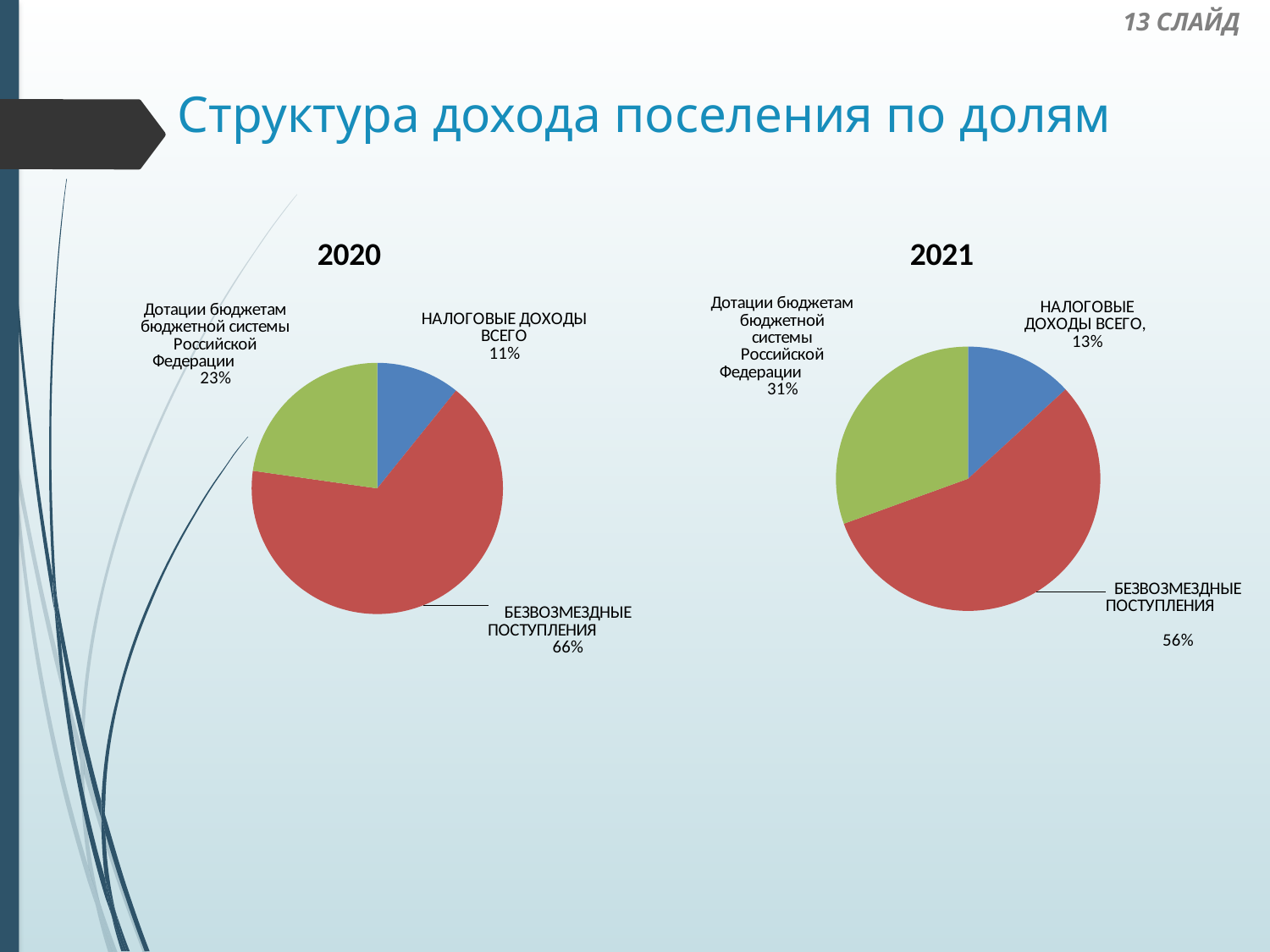
In the 2020 pie chart, which category has the largest slice? БЕЗВОЗМЕЗДНЫЕ ПОСТУПЛЕНИЯ In the 2021 pie chart, what share is labelled for Дотации бюджетам бюджетной системы Российской Федерации? 31% What kind of chart is used for the 2021 data? Pie chart Which is larger: the share of НАЛОГОВЫЕ ДОХОДЫ ВСЕГО in the 2020 chart or in the 2021 chart? 2021 In the 2021 pie chart, what share is labelled for НАЛОГОВЫЕ ДОХОДЫ ВСЕГО? 13% In the 2021 pie chart, which category has the smallest slice? НАЛОГОВЫЕ ДОХОДЫ ВСЕГО In the 2020 pie chart, what share is labelled for БЕЗВОЗМЕЗДНЫЕ ПОСТУПЛЕНИЯ? 66% How many slices does the 2020 pie chart have? 3 In the 2020 pie chart, what share is labelled for Дотации бюджетам бюджетной системы Российской Федерации? 23% What is the title of the slide containing the two pie charts? Структура дохода поселения по долям In the 2021 pie chart, what colour is the slice for Дотации бюджетам бюджетной системы Российской Федерации? Green What is the difference between the share of БЕЗВОЗМЕЗДНЫЕ ПОСТУПЛЕНИЯ in the 2020 chart and in the 2021 chart? 10%